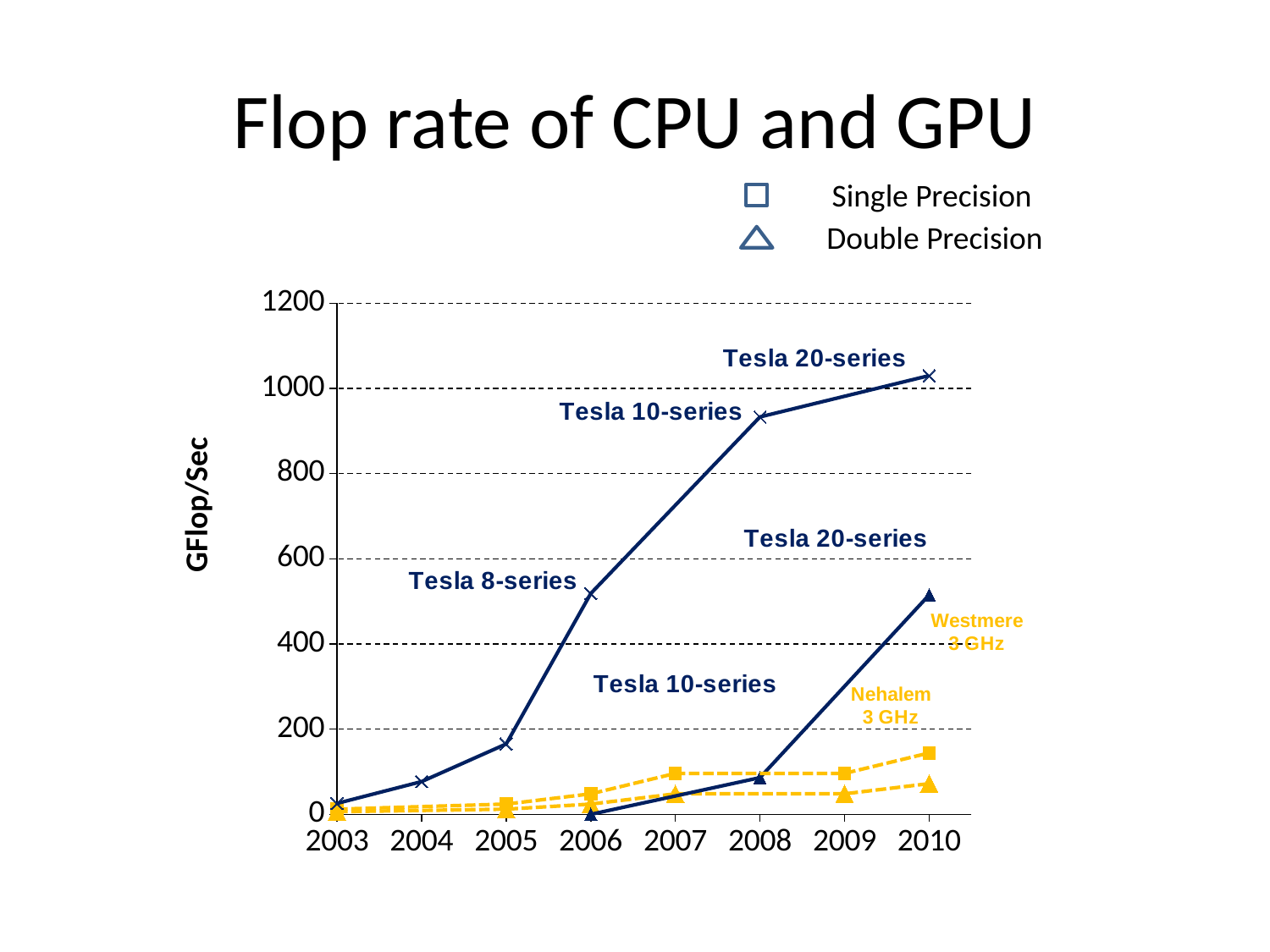
Is the CPU single precision value (Westmere 3 GHz) in 2010 greater or less than 200? less How many years are shown along the x axis? 8 What is the label on the y axis? GFlop/Sec Is the GPU single precision value (Tesla 20-series) in 2010 greater or less than 800? greater Which marker shape does the legend use for Double Precision? triangle In 2010, which is higher: the GPU single precision value or the GPU double precision value? GPU single precision Does the GPU single precision line rise or fall from 2003 to 2010? rise What kind of chart is shown on the slide? line chart Is the GPU double precision value (Tesla 20-series) in 2010 greater or less than 400? greater